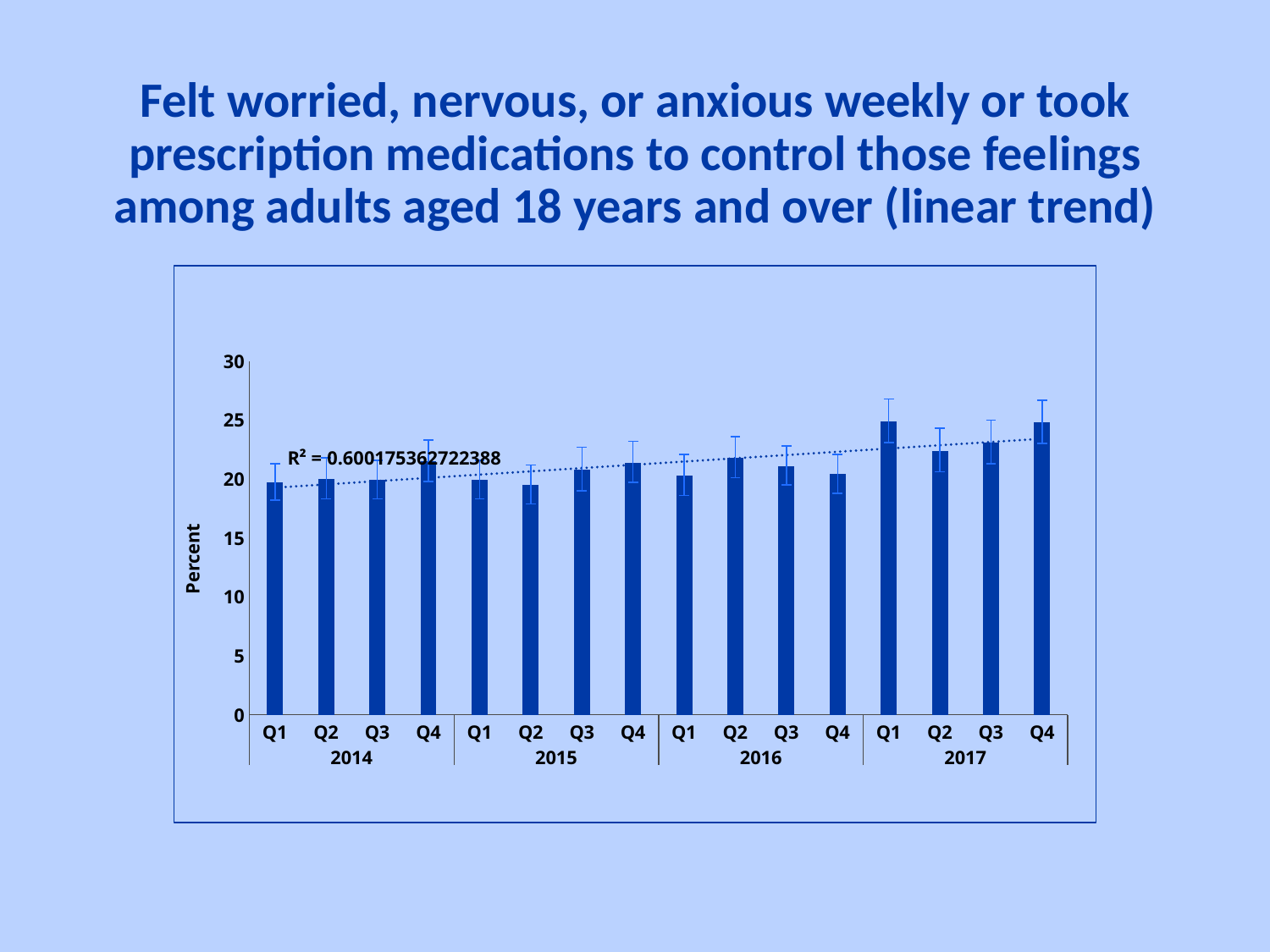
Is the value for Q2 2015 greater or less than 20? less Does the linear trend line rise or fall from 2014 to 2017? Rises What R² value is printed on the chart? R² = 0.600175362722388 Which is larger, the value for Q3 2017 or the value for Q3 2014? Q3 2017 Is the value for Q1 2014 greater or less than 25? less How many quarterly bars are plotted in the chart? 16 Is the value for Q1 2017 greater or less than 20? greater Which is larger, the value for Q1 2017 or the value for Q2 2015? Q1 2017 What is the label of the y axis? Percent What kind of chart is shown on the slide? Bar chart How many years are shown along the x axis of the chart? 4